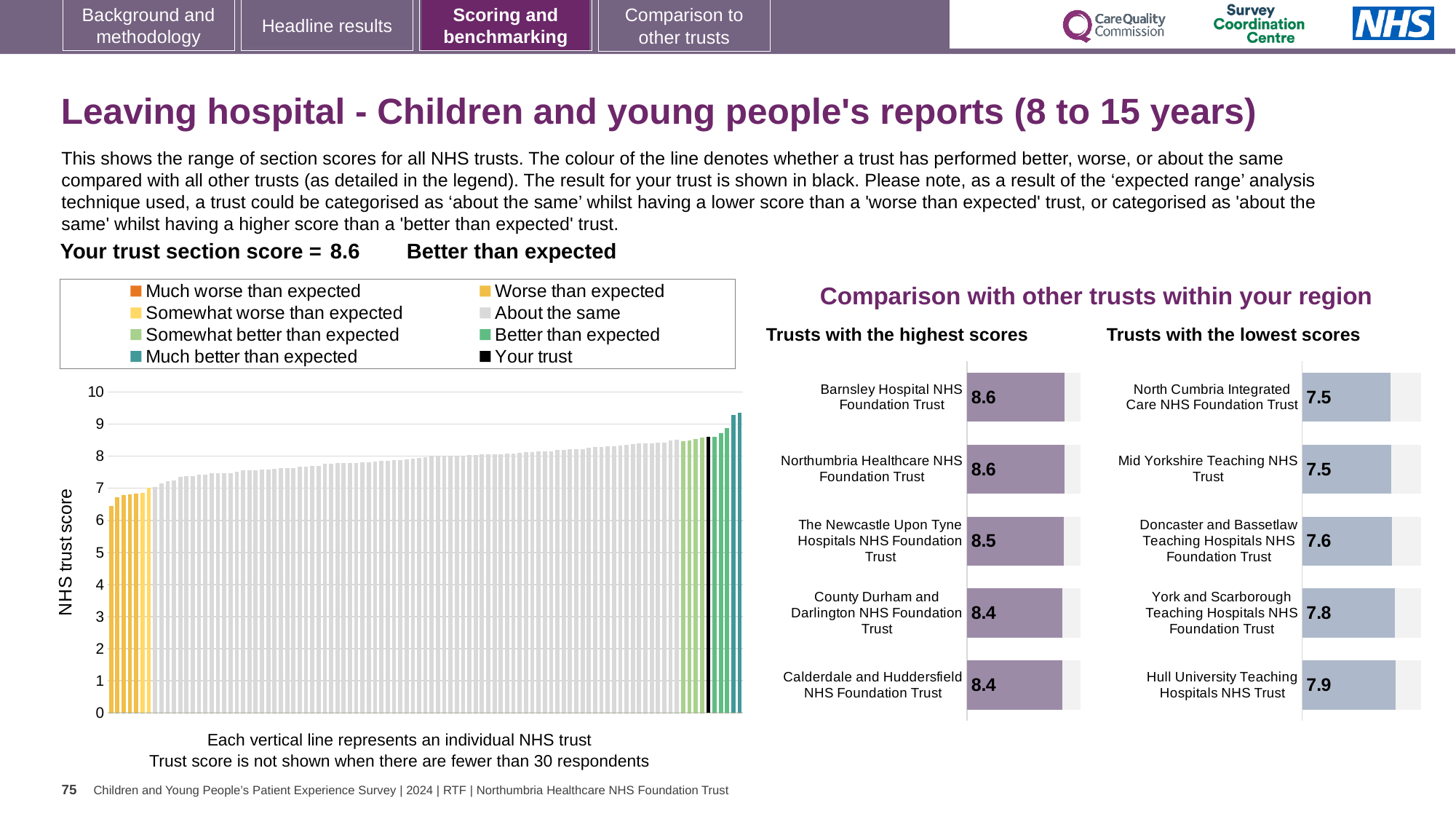
In the main chart on the left showing the range of section scores, is the value of the highest bar greater or less than 9? greater In the 'Trusts with the lowest scores' chart, which trust has the highest score? Hull University Teaching Hospitals NHS Trust In the 'Trusts with the lowest scores' chart, what is the difference between the scores of Hull University Teaching Hospitals NHS Trust and North Cumbria Integrated Care NHS Foundation Trust? 0.4 In the 'Trusts with the lowest scores' chart, which has the larger score: Hull University Teaching Hospitals NHS Trust or Doncaster and Bassetlaw Teaching Hospitals NHS Foundation Trust? Hull University Teaching Hospitals NHS Trust In the 'Trusts with the lowest scores' chart, what is the score for York and Scarborough Teaching Hospitals NHS Foundation Trust? 7.8 How many trusts are listed in the 'Trusts with the highest scores' chart? 5 How many entries does the legend of the main chart on the left list? 8 In the 'Trusts with the highest scores' chart, what is the difference between the scores of Barnsley Hospital NHS Foundation Trust and Calderdale and Huddersfield NHS Foundation Trust? 0.2 In the 'Trusts with the highest scores' chart, what is the score for Barnsley Hospital NHS Foundation Trust? 8.6 In the 'Trusts with the highest scores' chart, what is the score for The Newcastle Upon Tyne Hospitals NHS Foundation Trust? 8.5 What kind of chart is the main chart on the left showing the range of section scores? Bar chart In the main chart on the left showing the range of section scores, is the value of the lowest bar greater or less than 7? less